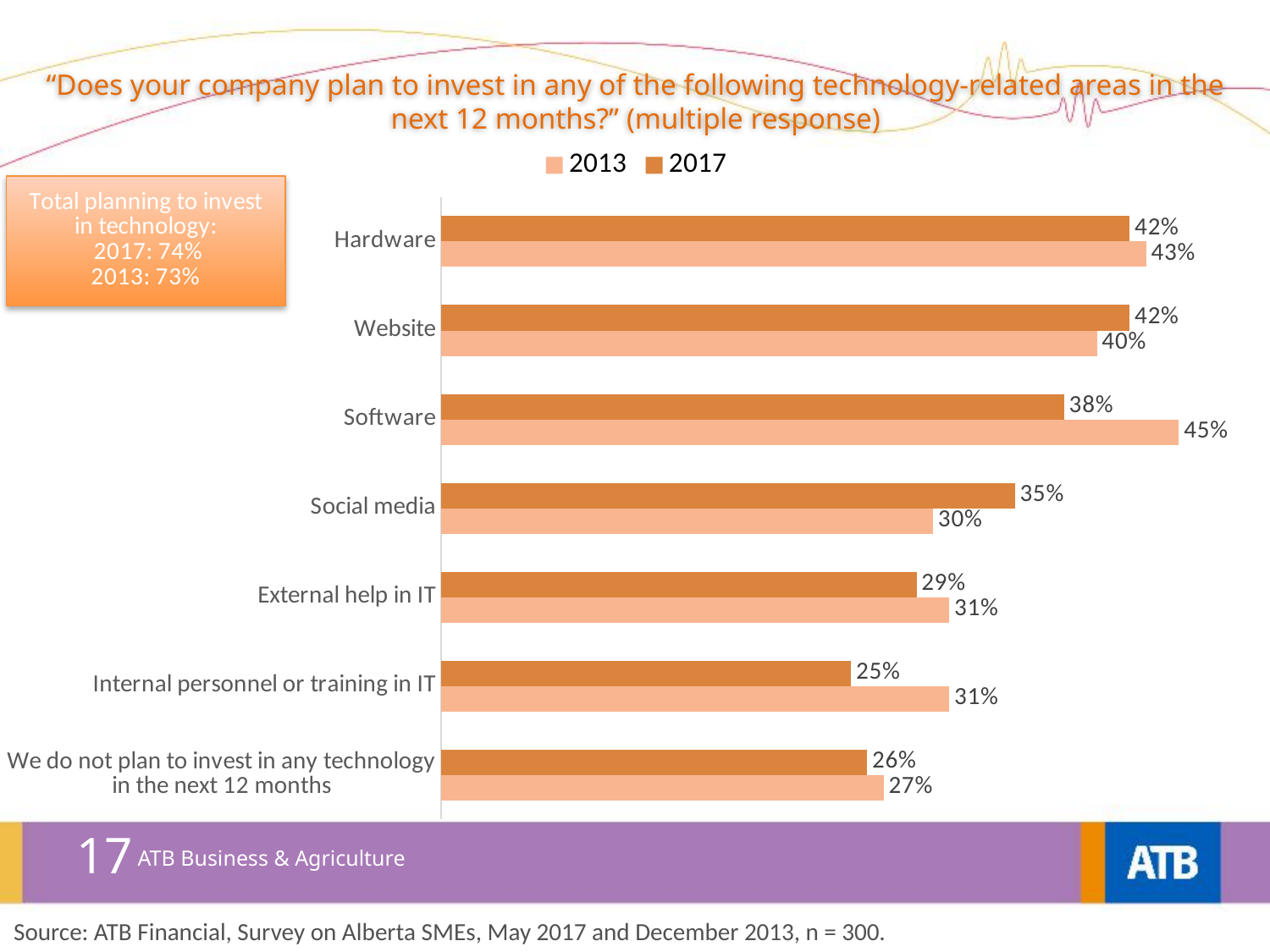
How many series does the legend list? 2 How many categories are shown on the chart? 7 What is the 2017 value for Social media? 35% Which category has the lowest 2017 value? Internal personnel or training in IT What percentage of companies planned to invest in Software in 2013? 45% What is the difference between the 2013 and 2017 values for Software? 7% Which category has the highest 2013 value? Software Which is larger for Social media, the 2013 value or the 2017 value? 2017 What kind of chart is shown on the slide? Bar chart Which is larger for External help in IT, the 2013 value or the 2017 value? 2013 What is the difference between the 2013 and 2017 values for Internal personnel or training in IT? 6% What is the 2017 value for Internal personnel or training in IT? 25%